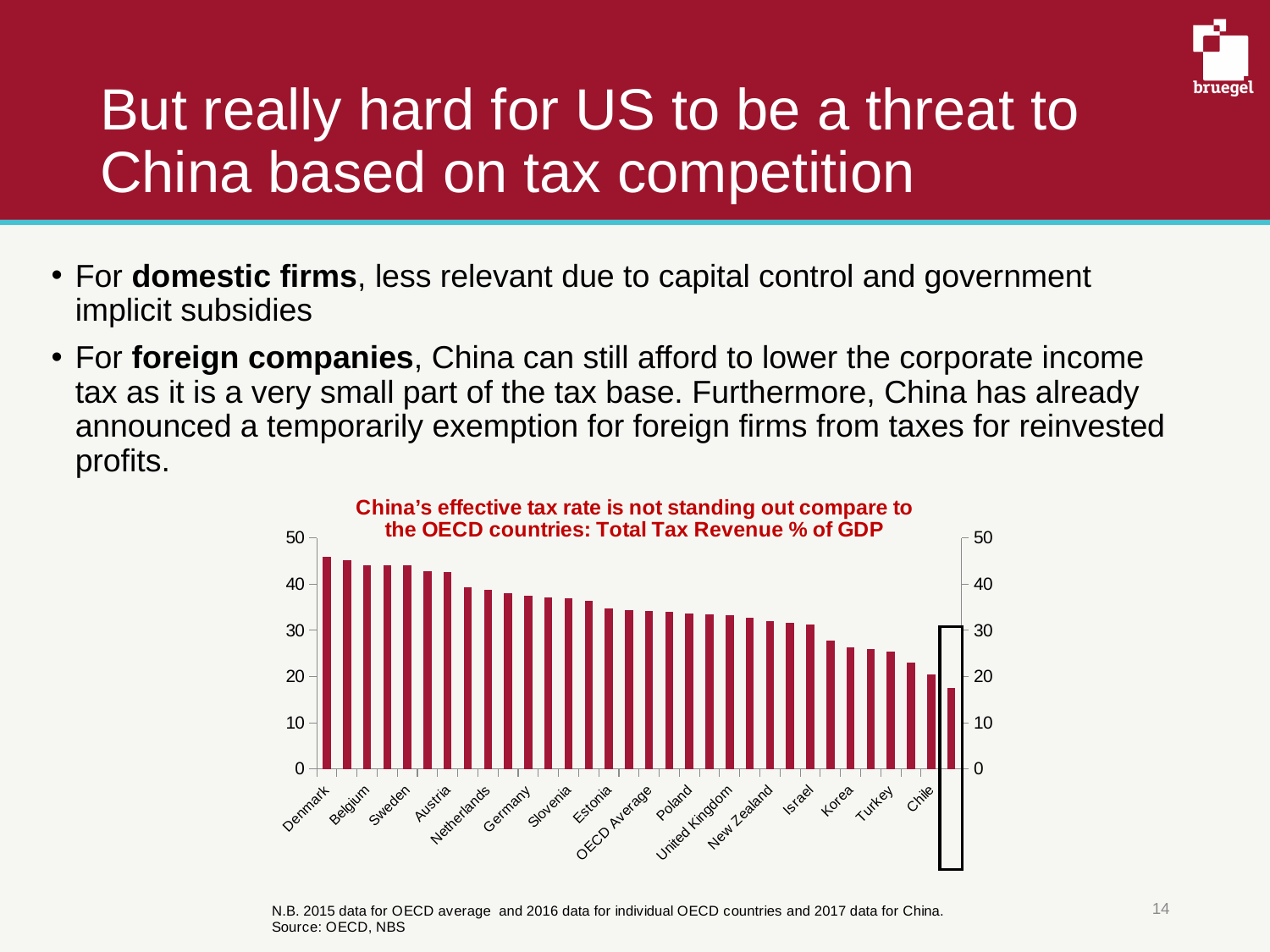
Is the value for Germany greater or less than 40? less Which has the larger value, Germany or Chile? Germany Is the value for Korea greater or less than 30? less Is the value for Turkey greater or less than 20? greater Which country has the highest total tax revenue as % of GDP in the chart? Denmark Do the bar values rise or fall from left to right along the x axis? fall What is the maximum value shown on the vertical axis of the chart? 50 Which has the larger value, Sweden or Turkey? Sweden What kind of chart is shown on the slide? bar chart